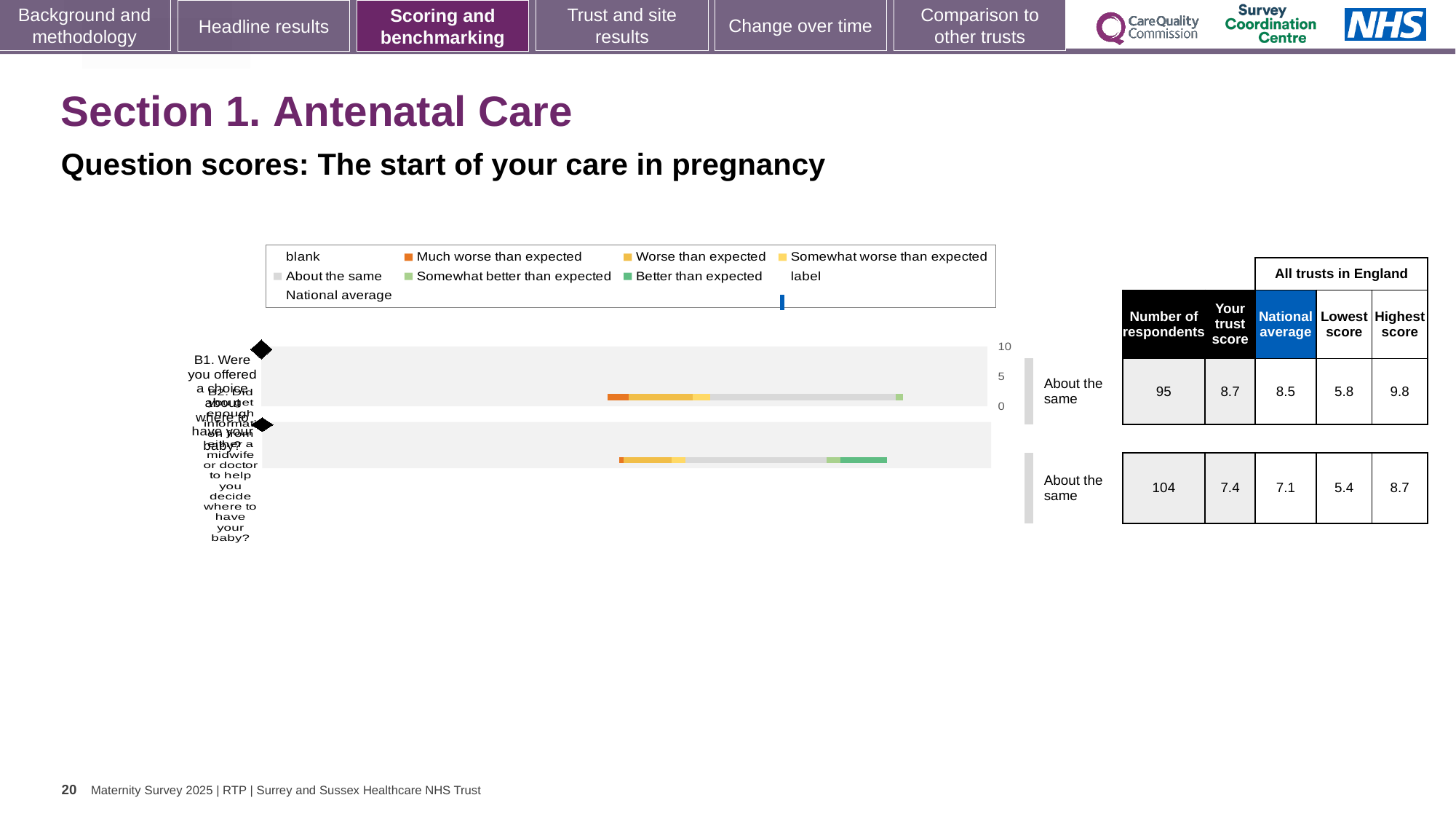
In the table beside the chart, what is the national average for question B2? 7.1 In the table beside the chart, what is the trust score for question B1? 8.7 What kind of chart is shown on the slide? bar chart What is the highest value shown on the chart's axis? 10 How many question categories (bars) are plotted in the chart? 2 In the table beside the chart, which question has the larger number of respondents, B1 or B2? B2 In the table beside the chart, what is the highest score for question B2? 8.7 Which legend entry is shown in orange in the chart? Much worse than expected In the table beside the chart, what is the number of respondents for question B1? 95 How many entries does the chart legend list? 9 In the table beside the chart, what is the difference between the trust score and the national average for question B1? 0.2 In the table beside the chart, what is the lowest score for question B1? 5.8